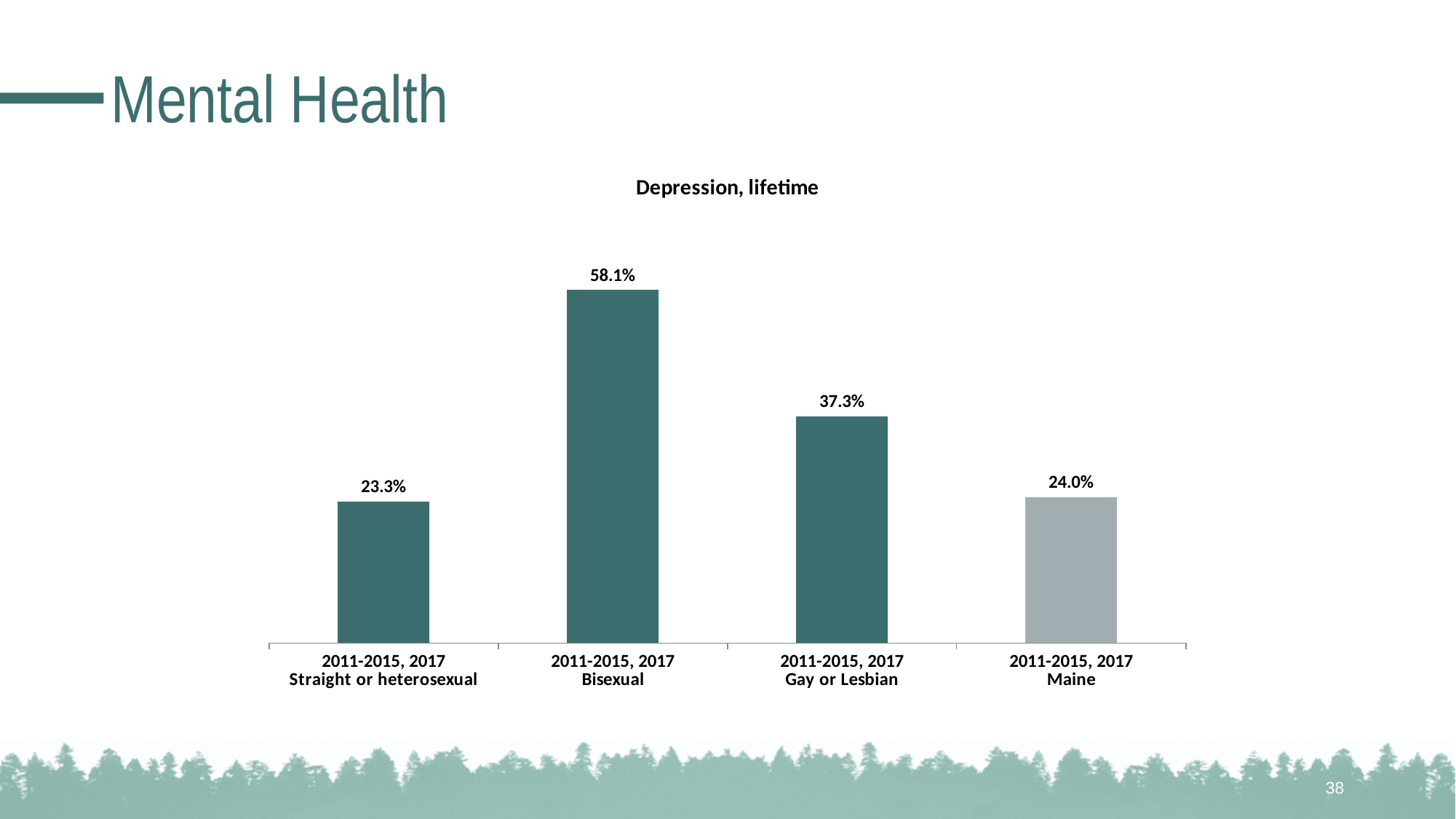
How many categories are shown in the chart? 4 Which is larger, the value for Gay or Lesbian or the value for Maine? Gay or Lesbian What is the lifetime depression value for Bisexual? 58.1% What is the lifetime depression value for Gay or Lesbian? 37.3% What kind of chart is shown on the slide? Bar chart What is the lifetime depression value for Maine? 24.0% Which category has the lowest lifetime depression value? Straight or heterosexual What is the difference between the Maine and Straight or heterosexual values? 0.7% What is the difference between the Bisexual and Gay or Lesbian values? 20.8% What is the lifetime depression value for Straight or heterosexual? 23.3% What is the title of the chart? Depression, lifetime Which category has the highest lifetime depression value? Bisexual